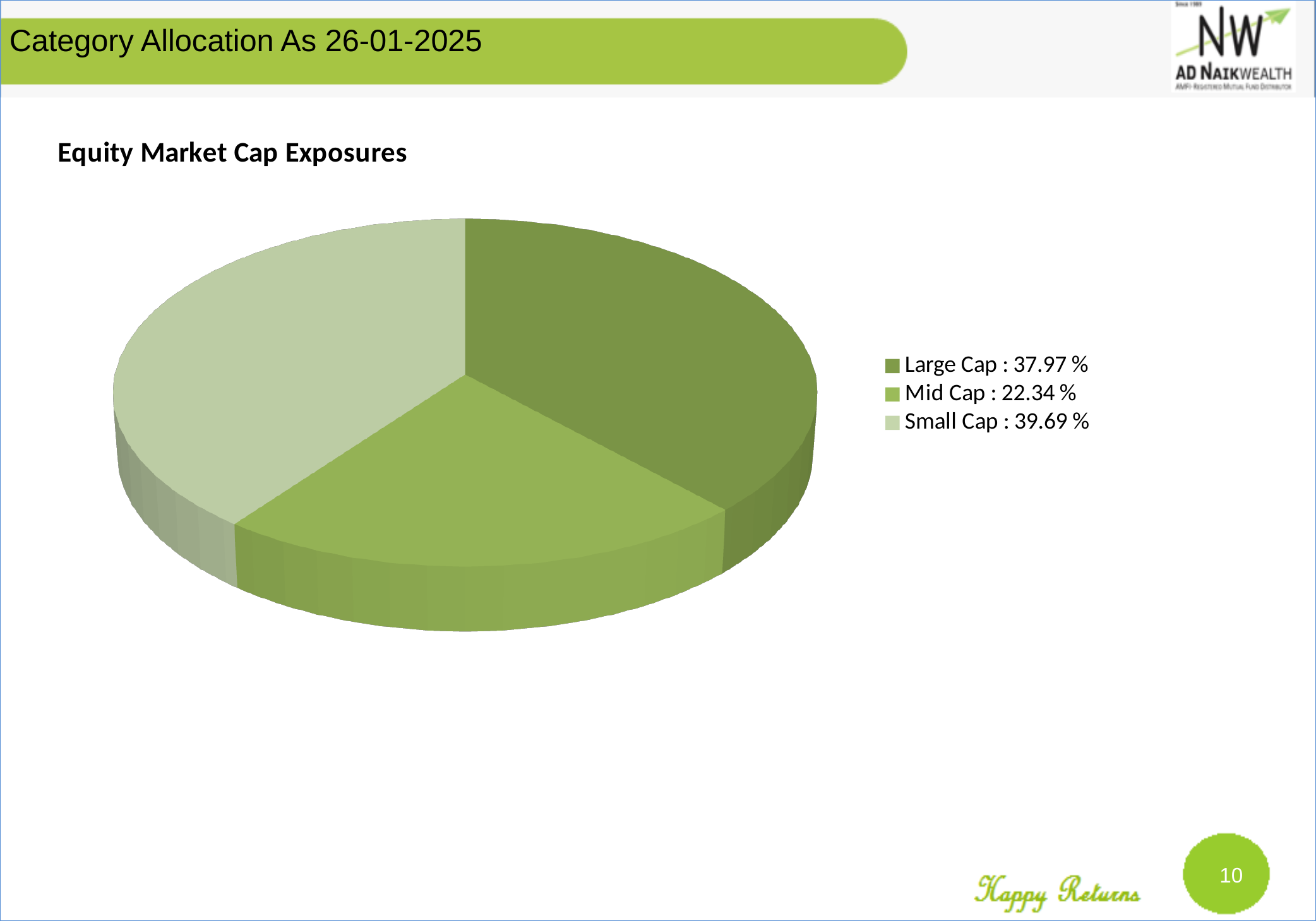
How many categories does the pie chart show? 3 What is the title of the chart? Equity Market Cap Exposures What is the value for Large Cap? 37.97 % Which category has the largest share? Small Cap What kind of chart is shown on the slide? Pie chart What is the difference between the Small Cap and Large Cap values? 1.72 % What is the value for Small Cap? 39.69 % What is the value for Mid Cap? 22.34 % Which is larger, Large Cap or Mid Cap? Large Cap Which category is shown in the lightest green colour? Small Cap Which category has the smallest share? Mid Cap What is the difference between the Large Cap and Mid Cap values? 15.63 %